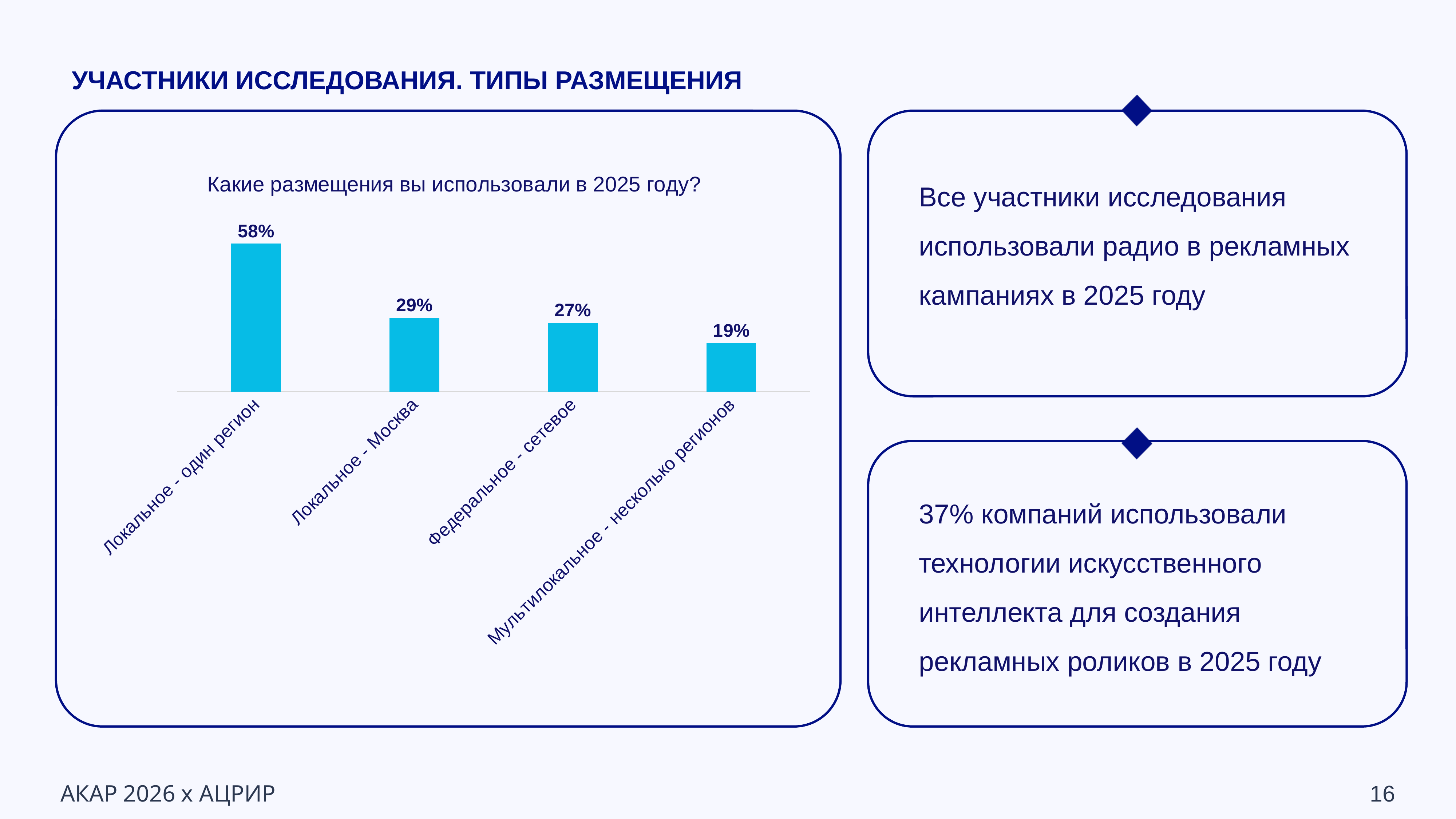
What kind of chart is shown on the slide? Bar chart What is the difference between the values for Локальное - один регион and Локальное - Москва? 29% What is the value for Локальное - один регион? 58% What is the difference between the values for Федеральное - сетевое and Мультилокальное - несколько регионов? 8% What is the value for Федеральное - сетевое? 27% How many categories are shown in the chart? 4 What is the value for Локальное - Москва? 29% Which category has the lowest value? Мультилокальное - несколько регионов Which category has the highest value? Локальное - один регион What is the title of the chart? Какие размещения вы использовали в 2025 году? What is the value for Мультилокальное - несколько регионов? 19% Which is larger, the value for Локальное - один регион or the value for Федеральное - сетевое? Локальное - один регион